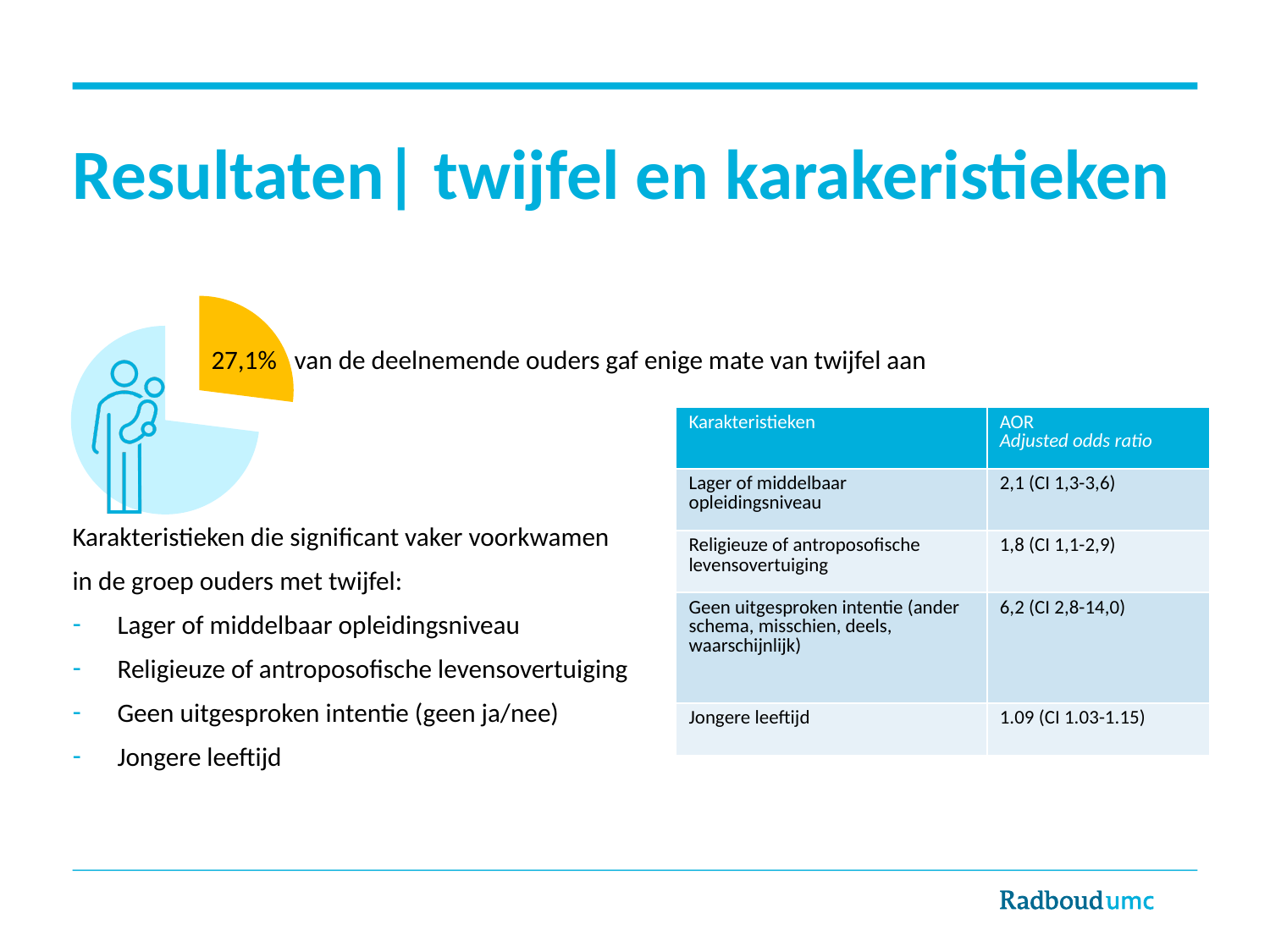
Which slice of the pie chart is larger, the yellow slice or the light blue slice? the light blue slice How many slices does the pie chart have? 2 What kind of chart is shown on the left of the slide? pie chart What share of the pie does the yellow slice represent? 27,1% According to the text next to the pie chart, what does the 27,1% slice represent? van de deelnemende ouders gaf enige mate van twijfel aan What percentage is printed on the highlighted slice of the pie chart? 27,1% What colour is the slice labelled 27,1% in the pie chart? yellow